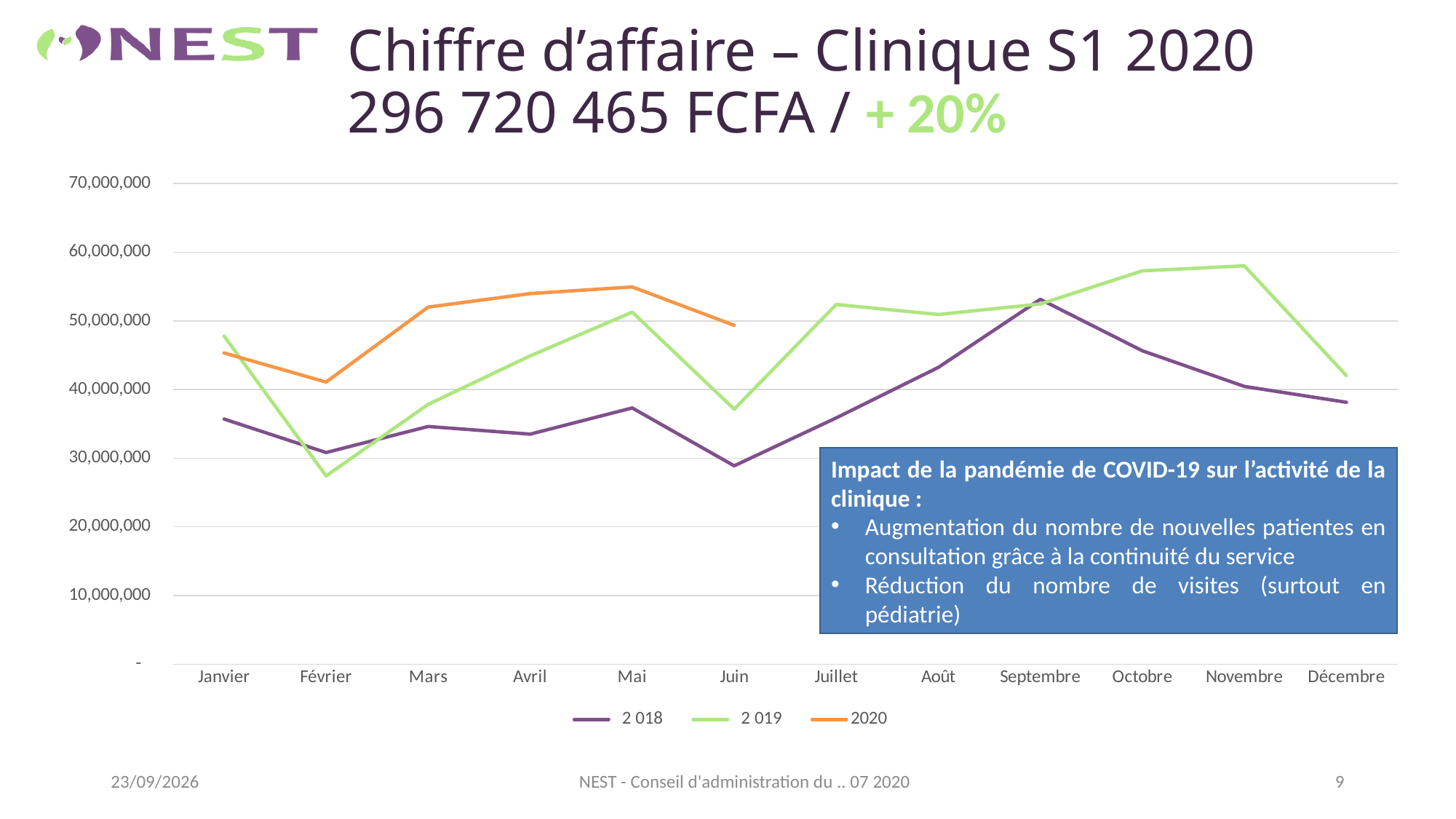
What kind of chart is shown on the slide? line chart Is the value for 2 019 in Février greater or less than 30,000,000? less In Juin, which series has the higher value, 2020 or 2 019? 2020 How many months are shown along the x axis? 12 In which month is the 2020 series at its lowest? Février Is the value for 2 018 in Juin greater or less than 30,000,000? less Is the value for 2 019 in Novembre greater or less than 50,000,000? greater Does the 2020 series rise or fall from Février to Mai? rise How many series does the legend list? 3 In which month is the 2 018 series at its highest? Septembre In which month is the 2 019 series at its lowest? Février